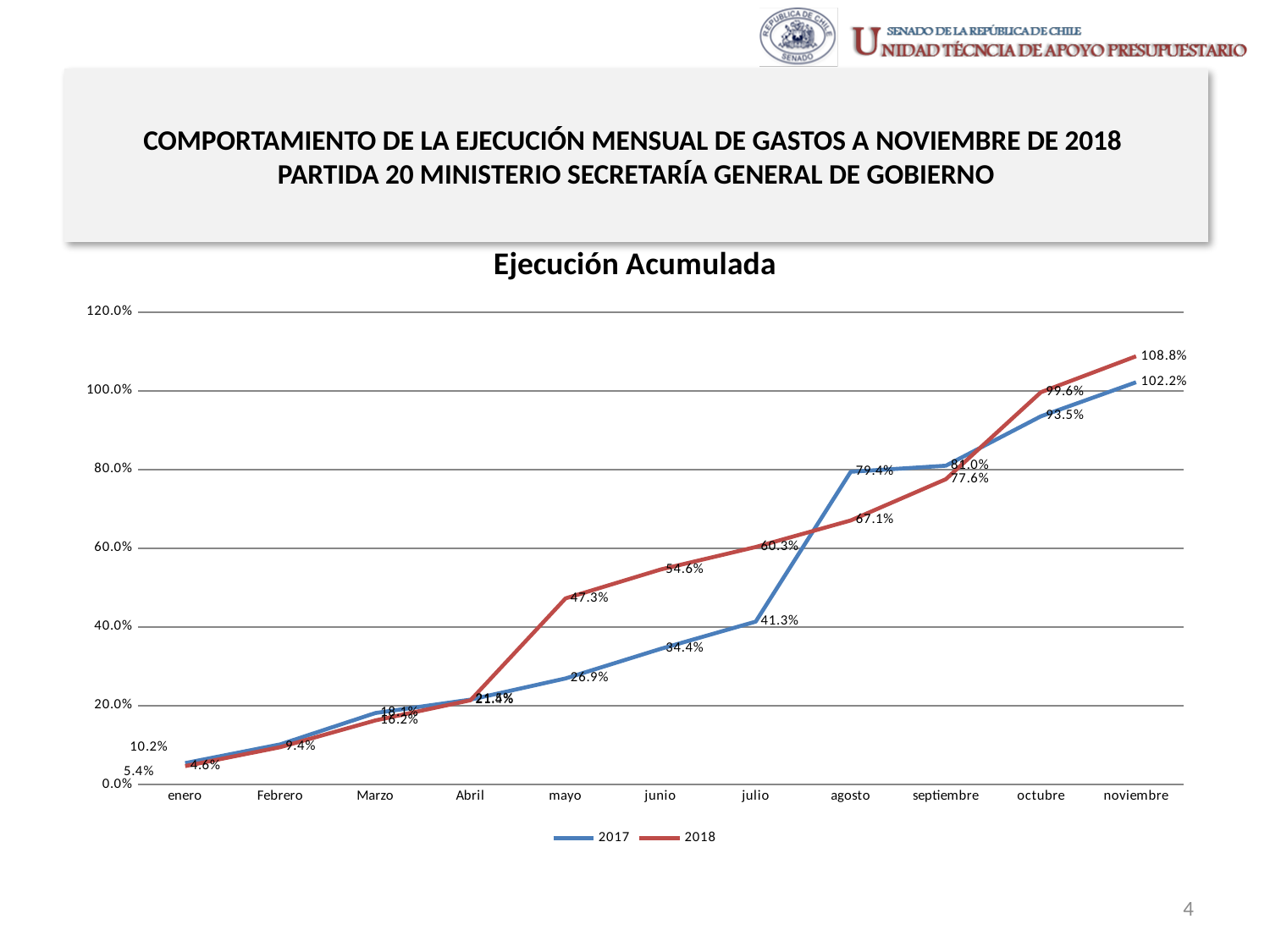
What is the value for 2018 in mayo? 47.3% What is the value for 2017 in agosto? 79.4% What kind of chart is shown? Line chart How many series does the legend list? 2 What is the value for 2017 in noviembre? 102.2% Do the values of the 2017 series rise or fall from enero to noviembre? Rise In junio, which series has the higher value, 2017 or 2018? 2018 In agosto, which series has the higher value, 2017 or 2018? 2017 How many months are shown on the x axis? 11 What is the difference between the 2018 and 2017 values in noviembre? 6.6 percentage points In which month does the 2018 series reach its highest value? noviembre What is the value for 2018 in noviembre? 108.8%